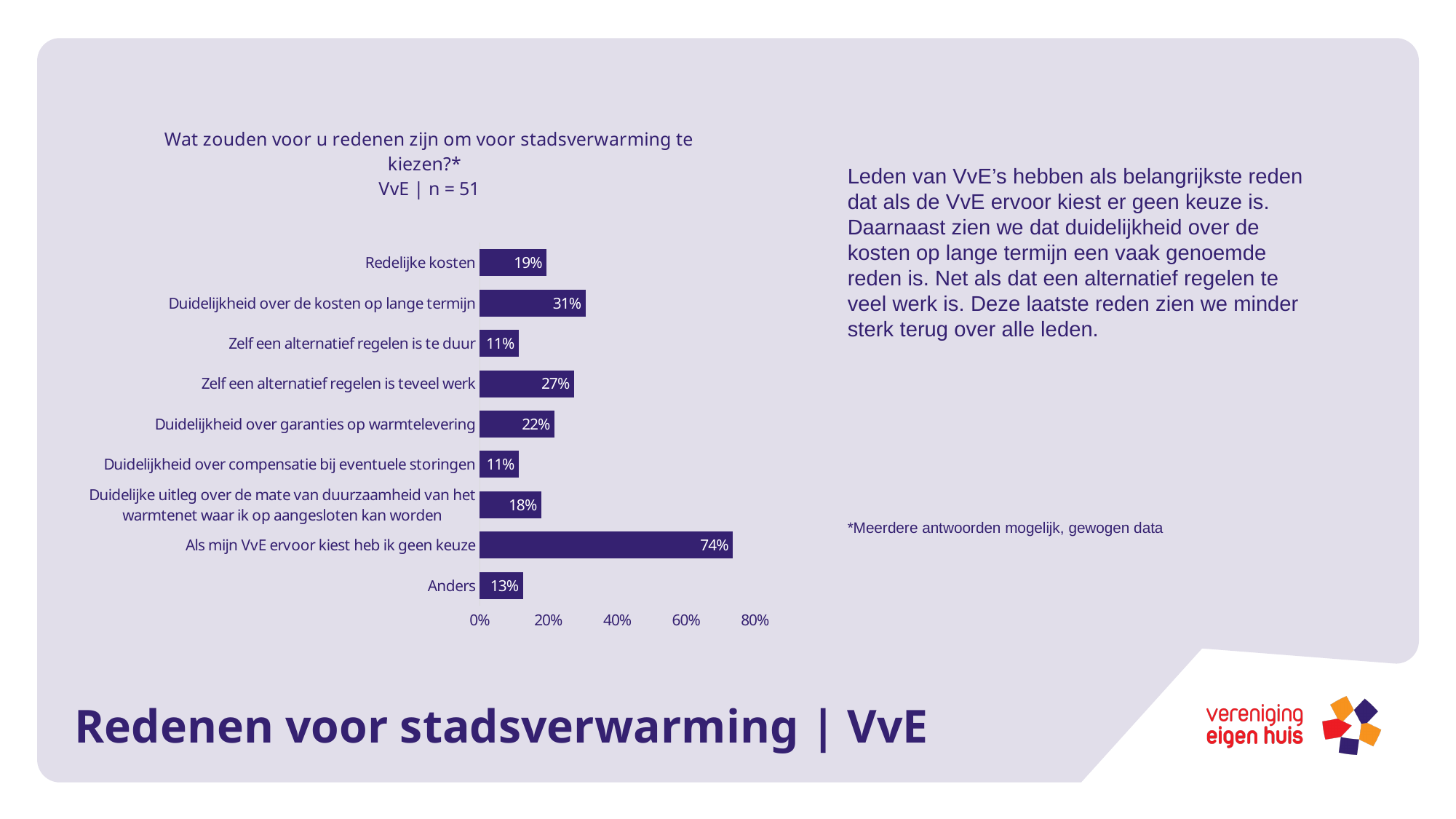
What is the value for "Als mijn VvE ervoor kiest heb ik geen keuze"? 74% What is the difference between "Redelijke kosten" and "Zelf een alternatief regelen is te duur"? 8% How many categories are shown in the chart? 9 Is the value for "Als mijn VvE ervoor kiest heb ik geen keuze" greater or less than 60%? greater Which is larger: "Zelf een alternatief regelen is teveel werk" or "Duidelijkheid over garanties op warmtelevering"? Zelf een alternatief regelen is teveel werk What is the sample size (n) stated in the chart title? 51 What is the value for "Anders"? 13% What kind of chart is shown on the slide? Bar chart Which category has the highest value? Als mijn VvE ervoor kiest heb ik geen keuze What is the difference between "Als mijn VvE ervoor kiest heb ik geen keuze" and "Duidelijkheid over de kosten op lange termijn"? 43% What is the value for "Duidelijkheid over de kosten op lange termijn"? 31% What is the value for "Redelijke kosten"? 19%